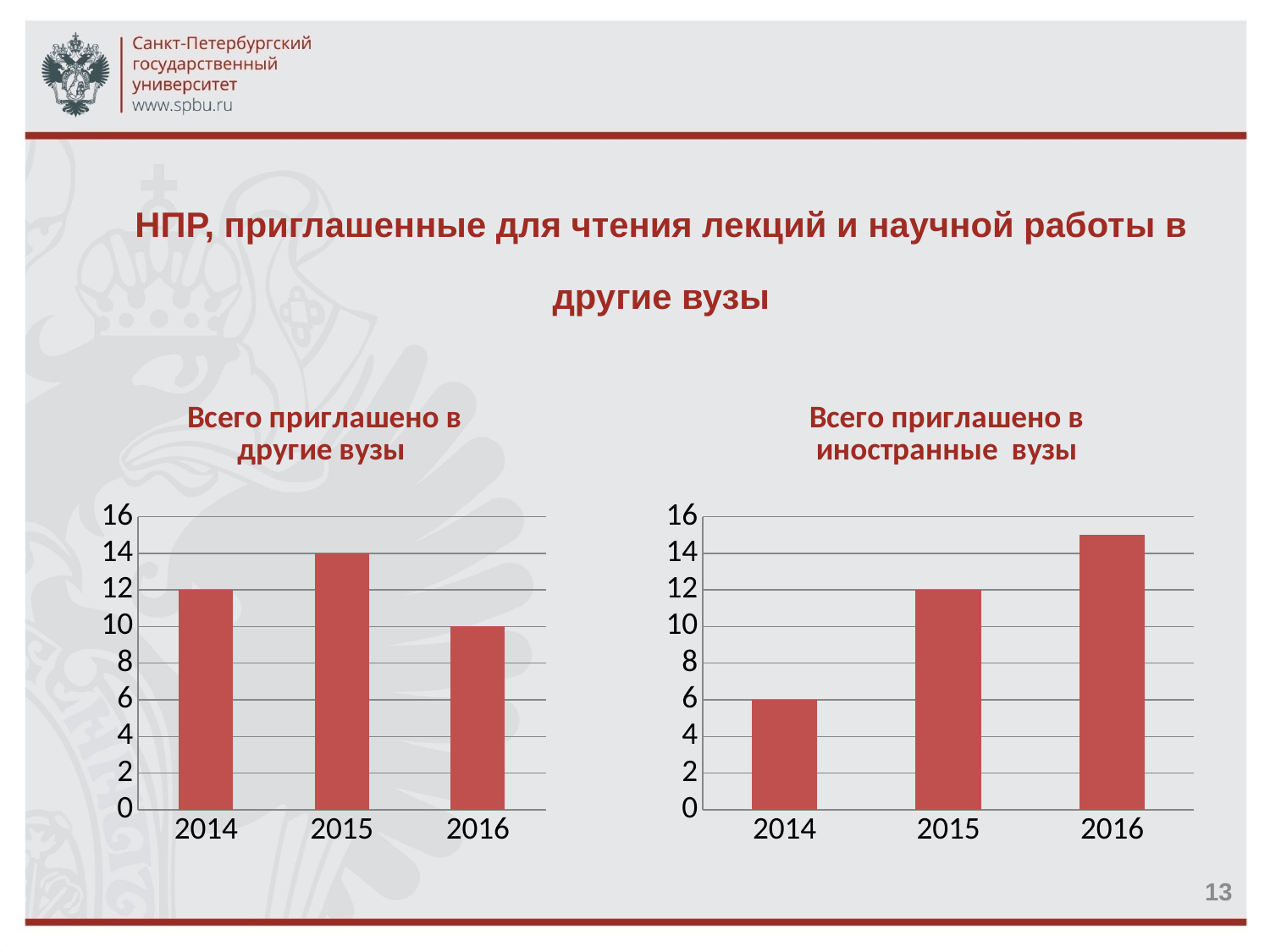
In the chart titled "Всего приглашено в другие вузы", what is the value for 2015? 14 In the chart titled "Всего приглашено в другие вузы", which year has the lowest value? 2016 In the chart titled "Всего приглашено в иностранные вузы", what is the value for 2014? 6 In the chart titled "Всего приглашено в иностранные вузы", which year has the lowest value? 2014 In the chart titled "Всего приглашено в иностранные вузы", what is the value for 2015? 12 In the chart titled "Всего приглашено в иностранные вузы", do the values rise or fall from 2014 to 2016? rise What kind of chart is the chart titled "Всего приглашено в иностранные вузы"? bar chart In the chart titled "Всего приглашено в другие вузы", which year has the highest value? 2015 How many years are shown on the x axis of the chart titled "Всего приглашено в другие вузы"? 3 In the chart titled "Всего приглашено в иностранные вузы", is the value for 2016 greater or less than 14? greater In the chart titled "Всего приглашено в другие вузы", what is the difference between the values for 2015 and 2016? 4 In the chart titled "Всего приглашено в другие вузы", what is the value for 2016? 10